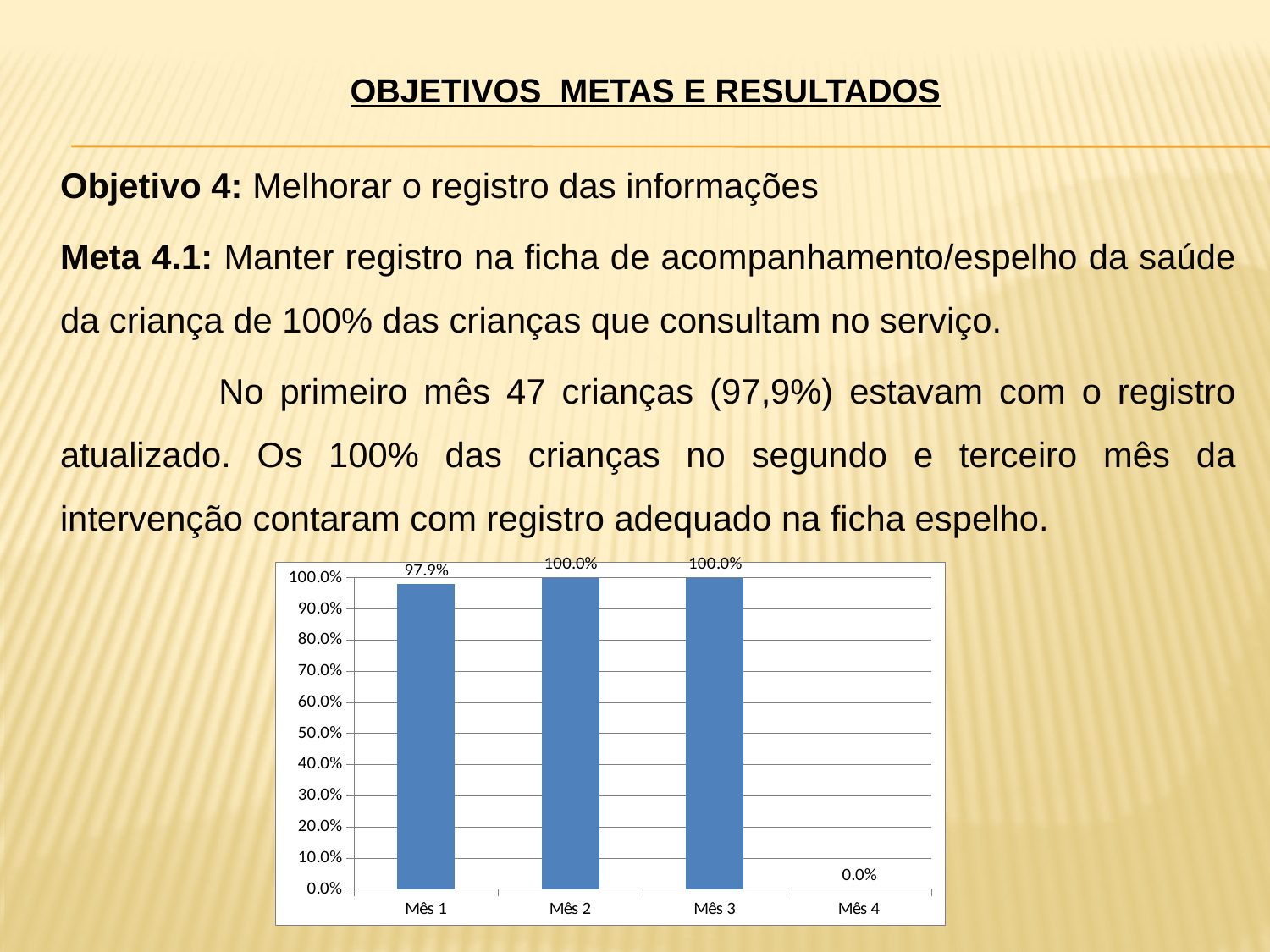
How many categories are shown on the x axis? 4 Which is larger, the value for Mês 1 or the value for Mês 3? Mês 3 Which category has the lowest value? Mês 4 What is the value for Mês 2? 100.0% What is the difference between the values for Mês 2 and Mês 1? 2.1% Do the values rise or fall from Mês 1 to Mês 2? rise What is the value for Mês 4? 0.0% What is the highest value shown on the y axis? 100.0% What is the value for Mês 1? 97.9% Is the value for Mês 1 greater or less than 90.0%? greater What kind of chart is shown on the slide? bar chart Do the values for Mês 2 and Mês 3 differ? No, both are 100.0%